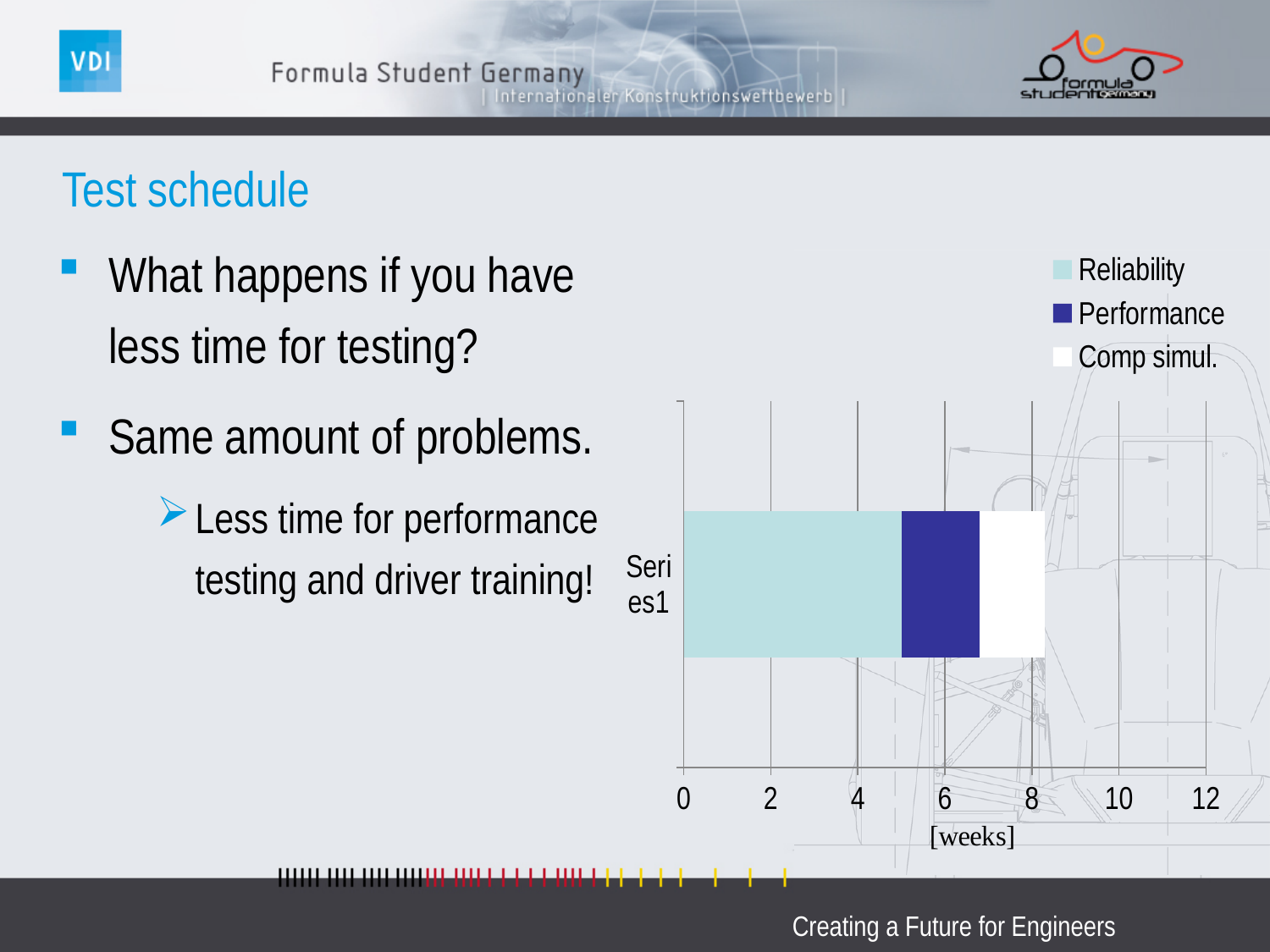
Which series has the largest segment in the stacked bar? Reliability How many series does the chart legend list? 3 How many categories are plotted on the chart? 1 What unit is shown on the x axis of the chart? [weeks] What is the label of the category on the chart's vertical axis? Series1 Is the total length of the stacked bar greater or less than 10? less Is the value for Reliability greater or less than 6? less What kind of chart is shown on the slide? bar chart Is the value for Reliability greater or less than 4? greater Which is larger, the Reliability segment or the Performance segment? Reliability